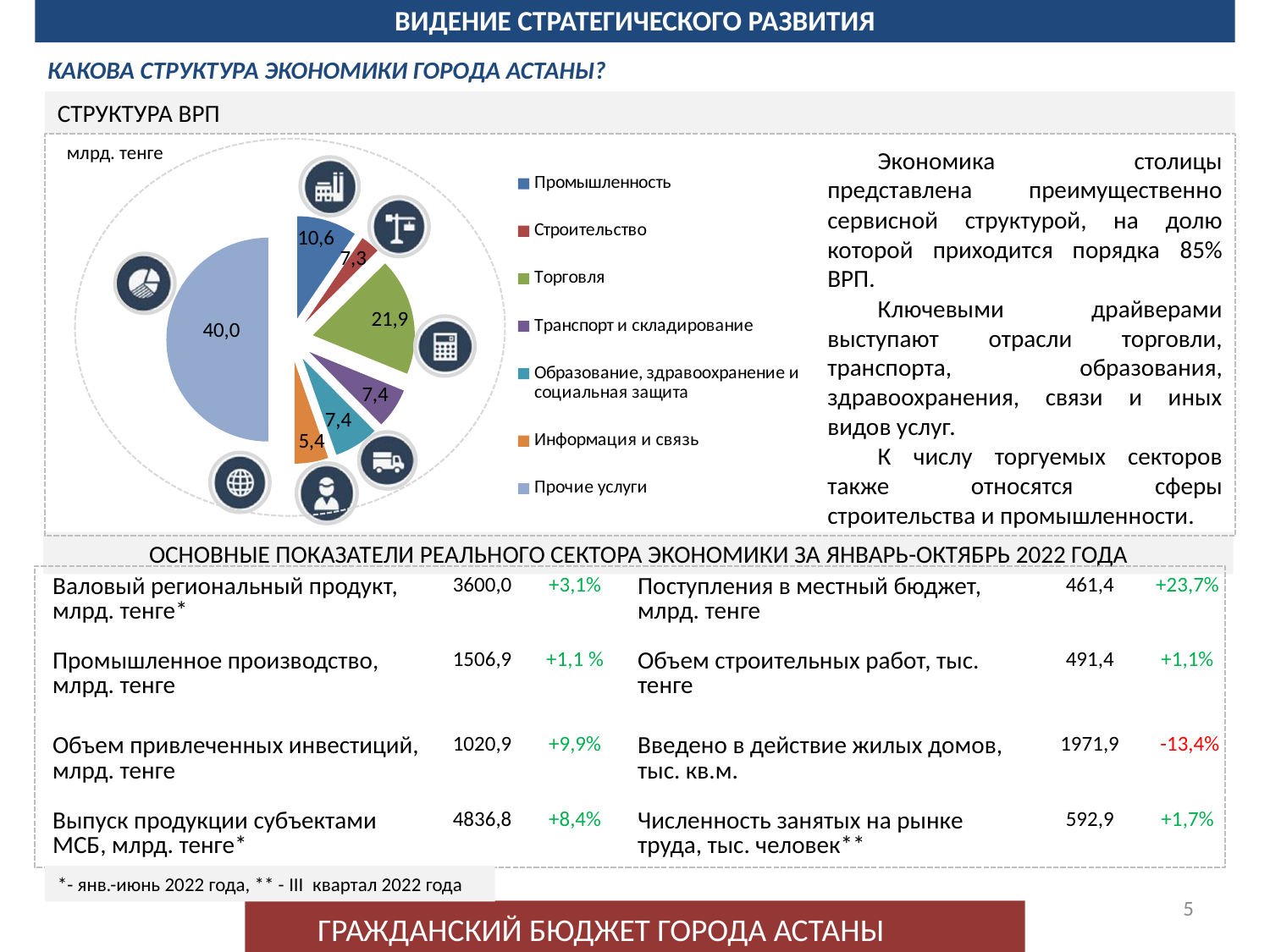
In the СТРУКТУРА ВРП pie chart, what is the value for Информация и связь? 5,4 In the СТРУКТУРА ВРП pie chart, what is the difference between Прочие услуги and Торговля? 18,1 How many categories are shown in the СТРУКТУРА ВРП pie chart? 7 In the СТРУКТУРА ВРП pie chart, what is the value for Строительство? 7,3 In the СТРУКТУРА ВРП pie chart, what share of the total does Прочие услуги represent? 40% What type of chart is used to show the structure of GRP (СТРУКТУРА ВРП)? Pie chart In the СТРУКТУРА ВРП pie chart, which is larger: Промышленность or Строительство? Промышленность Which category has the largest slice in the СТРУКТУРА ВРП pie chart? Прочие услуги In the СТРУКТУРА ВРП pie chart, what is the value for Торговля? 21,9 In the СТРУКТУРА ВРП pie chart, what is the value for Промышленность? 10,6 What unit is indicated for the values in the СТРУКТУРА ВРП pie chart? млрд. тенге